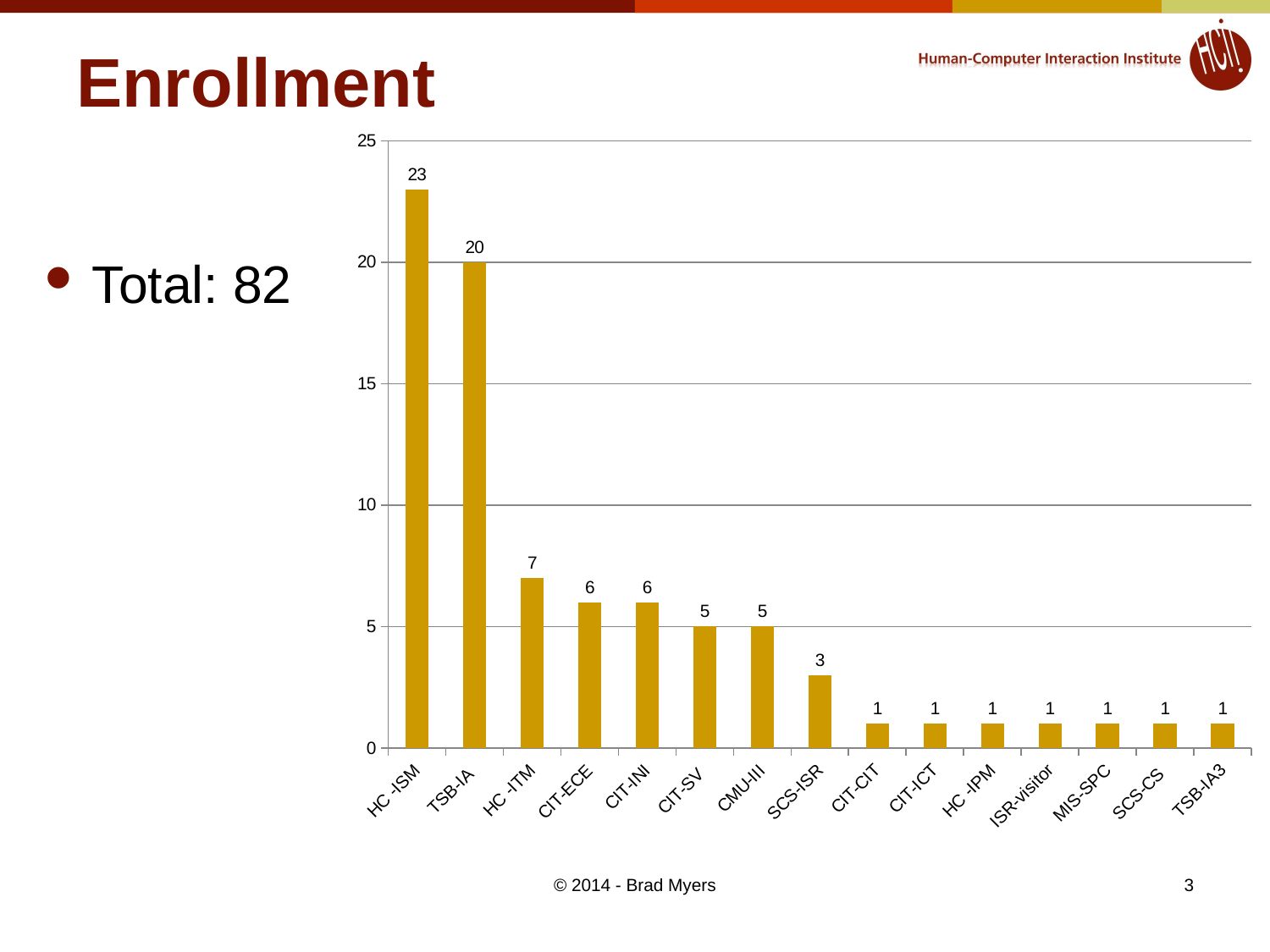
Is the value for TSB-IA greater or less than 15? greater What is the enrollment value for SCS-ISR? 3 What is the enrollment value for HC-ISM? 23 What is the enrollment value for HC-ITM? 7 What is the difference in enrollment between HC-ITM and CIT-SV? 2 What kind of chart is shown on the slide? Bar chart What is the difference in enrollment between HC-ISM and TSB-IA? 3 How many categories are shown on the x axis of the chart? 15 Which category has the highest enrollment? HC-ISM Which has a larger enrollment, CIT-ECE or SCS-ISR? CIT-ECE What is the enrollment value for TSB-IA? 20 Do the values rise or fall moving from left to right along the x axis? Fall